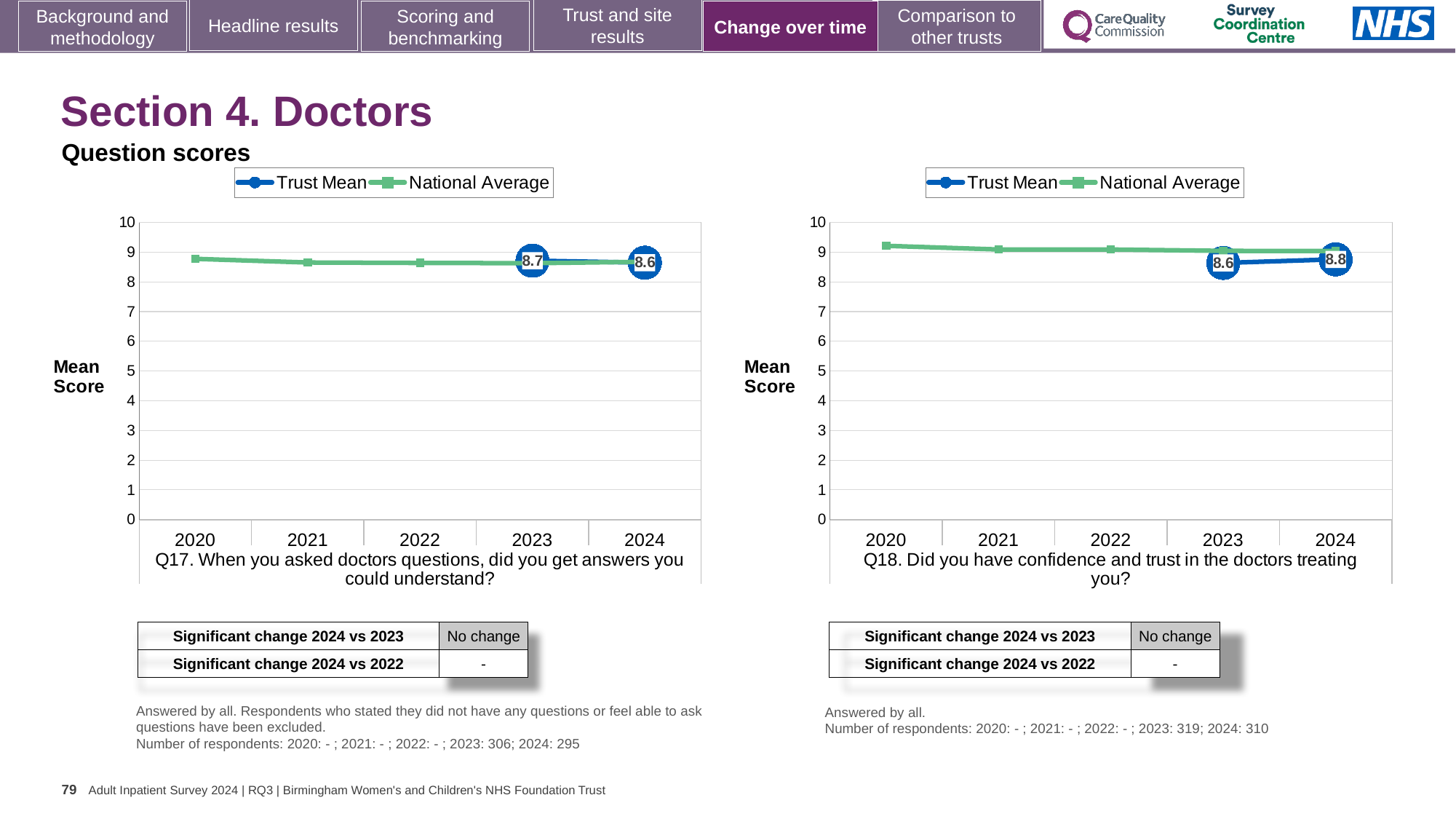
In the Q18 chart (right), which is larger, the Trust Mean for 2023 or for 2024? 2024 In the Q18 chart (right), is the National Average value for 2020 greater or less than 9? greater In the Q18 chart (right), what is the Trust Mean value for 2023? 8.6 In the Q18 chart (right), by how much did the Trust Mean change from 2023 to 2024? 0.2 How many series does the legend of the Q18 chart (right) list? 2 In the Q18 chart (right), did the Trust Mean rise or fall from 2023 to 2024? rise What type of chart is the Q17 chart (left)? line chart In the Q17 chart (left), what is the Trust Mean value for 2024? 8.6 In the Q17 chart (left), did the Trust Mean rise or fall from 2023 to 2024? fall How many years are shown on the x axis of the Q17 chart (left)? 5 In the Q18 chart (right), what is the Trust Mean value for 2024? 8.8 In the Q17 chart (left), what is the Trust Mean value for 2023? 8.7